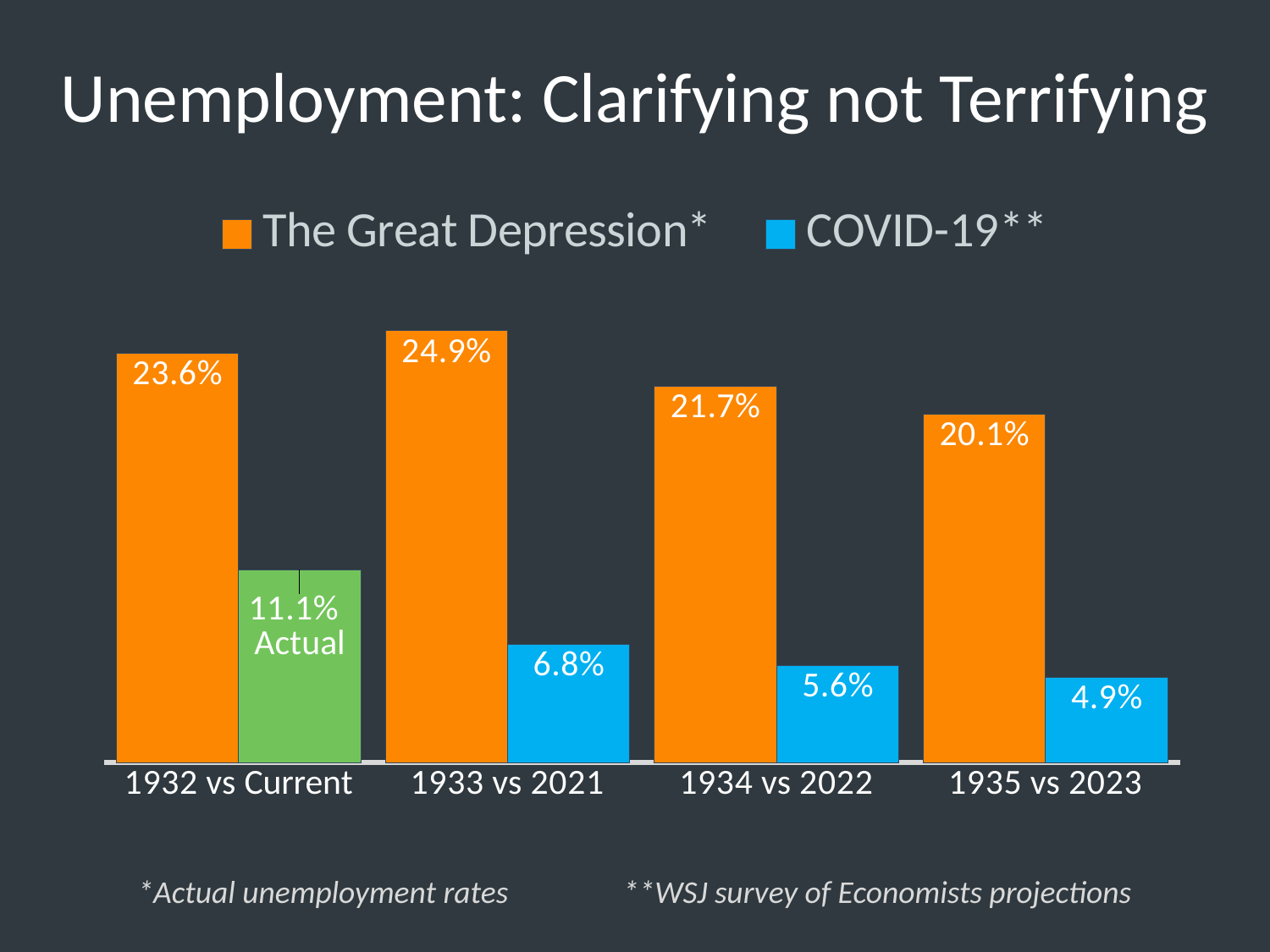
Do the COVID-19 values rise or fall from left to right across the categories? Fall Which category has the highest Great Depression unemployment rate? 1933 vs 2021 What kind of chart is shown on the slide? Bar chart Which is larger: the COVID-19 value for "1933 vs 2021" or for "1934 vs 2022"? 1933 vs 2021 How many categories are shown on the x axis? 4 What is the COVID-19 value shown for the "1935 vs 2023" category? 4.9% How many series does the legend list? 2 Which category has the lowest COVID-19 value? 1935 vs 2023 What is the title of the slide? Unemployment: Clarifying not Terrifying What is the Great Depression unemployment rate shown for the "1933 vs 2021" category? 24.9% What is the difference between the Great Depression and COVID-19 values in the "1934 vs 2022" category? 16.1% What is the COVID-19 value shown for the "1932 vs Current" category? 11.1%